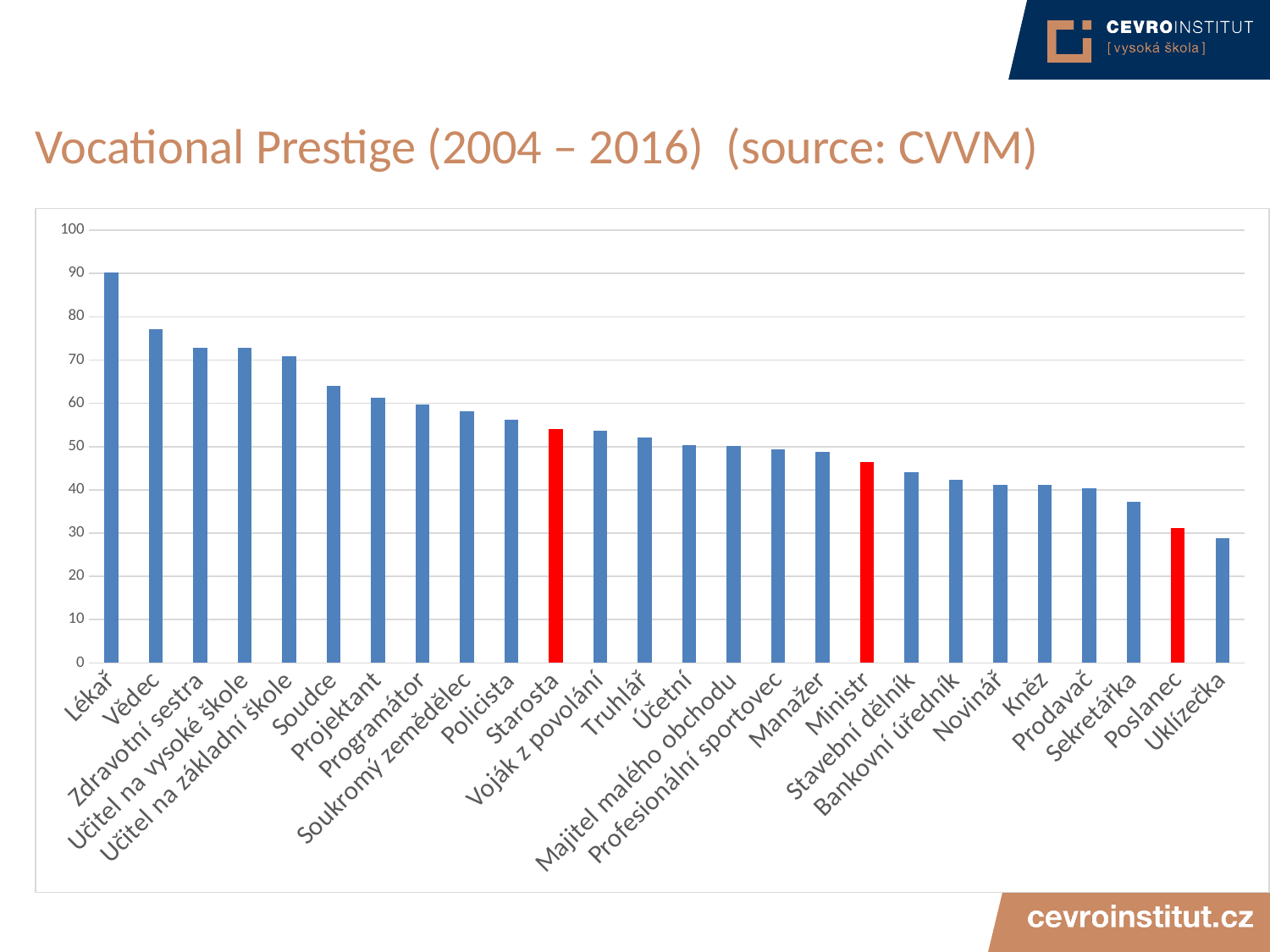
Which category has the lowest value? Uklízečka Is the value for Ministr greater or less than 50? less Which is larger, the value for Starosta or the value for Ministr? Starosta Is the value for Uklízečka greater or less than 40? less Is the value for Lékař greater or less than 80? greater Which three categories are shown with red bars? Starosta, Ministr, Poslanec Do the values generally rise or fall from left to right along the x axis? fall How many categories are plotted on the x axis? 26 What kind of chart is shown on the slide? bar chart Which category has the highest value? Lékař